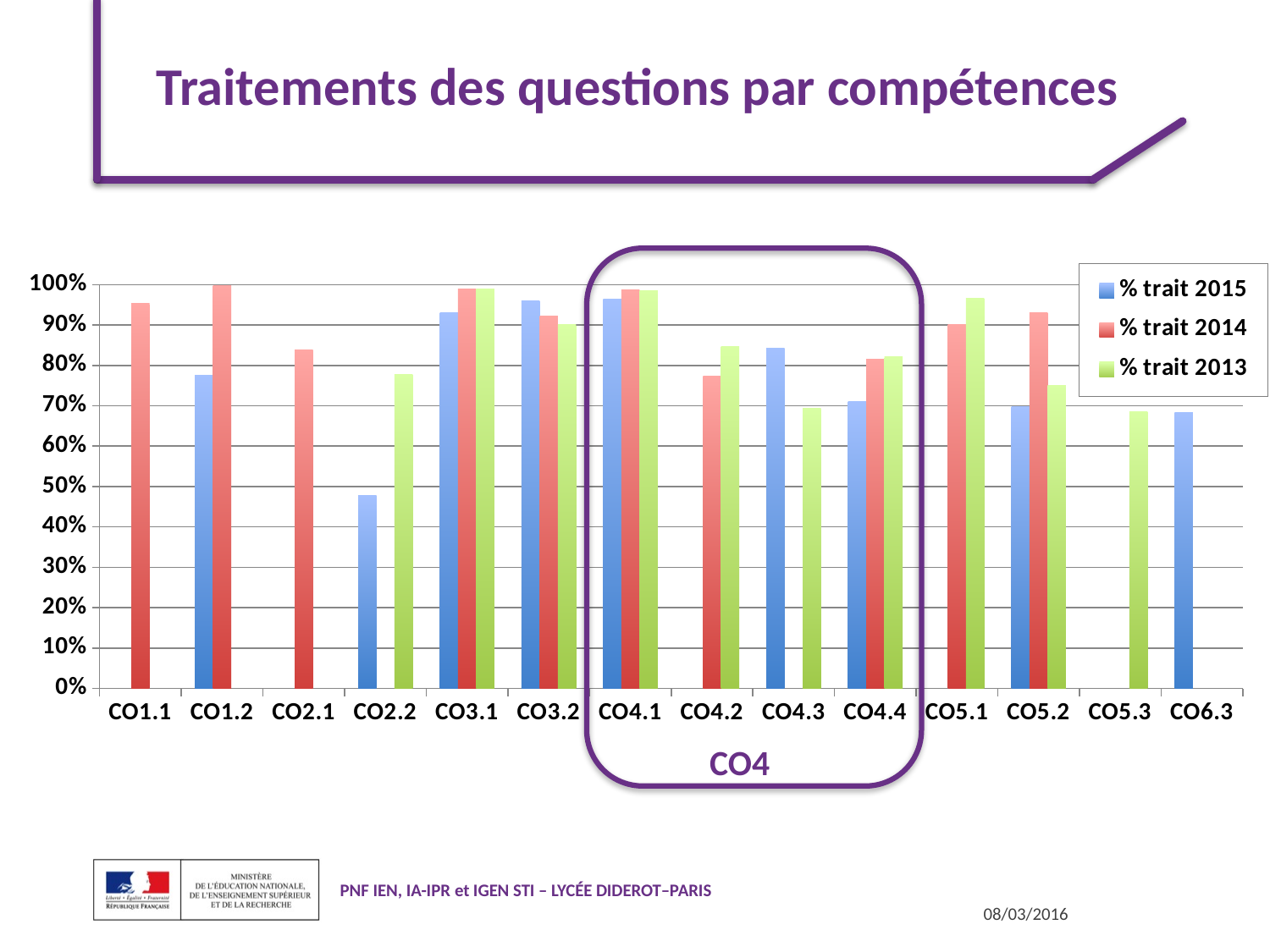
Is the value for % trait 2015 at CO2.2 greater or less than 60%? less Which category has the lowest value for % trait 2015? CO2.2 At CO5.2, which is larger: % trait 2014 or % trait 2015? % trait 2014 What is the title of the chart? Traitements des questions par compétences Is the value for % trait 2013 at CO4.3 greater or less than 80%? less Which group of categories is circled and labelled below the chart? CO4 What kind of chart is shown on the slide? bar chart Is the value for % trait 2014 at CO1.1 greater or less than 90%? greater At CO2.2, which is larger: % trait 2015 or % trait 2013? % trait 2013 How many series does the legend list? 3 How many categories are shown on the x axis? 14